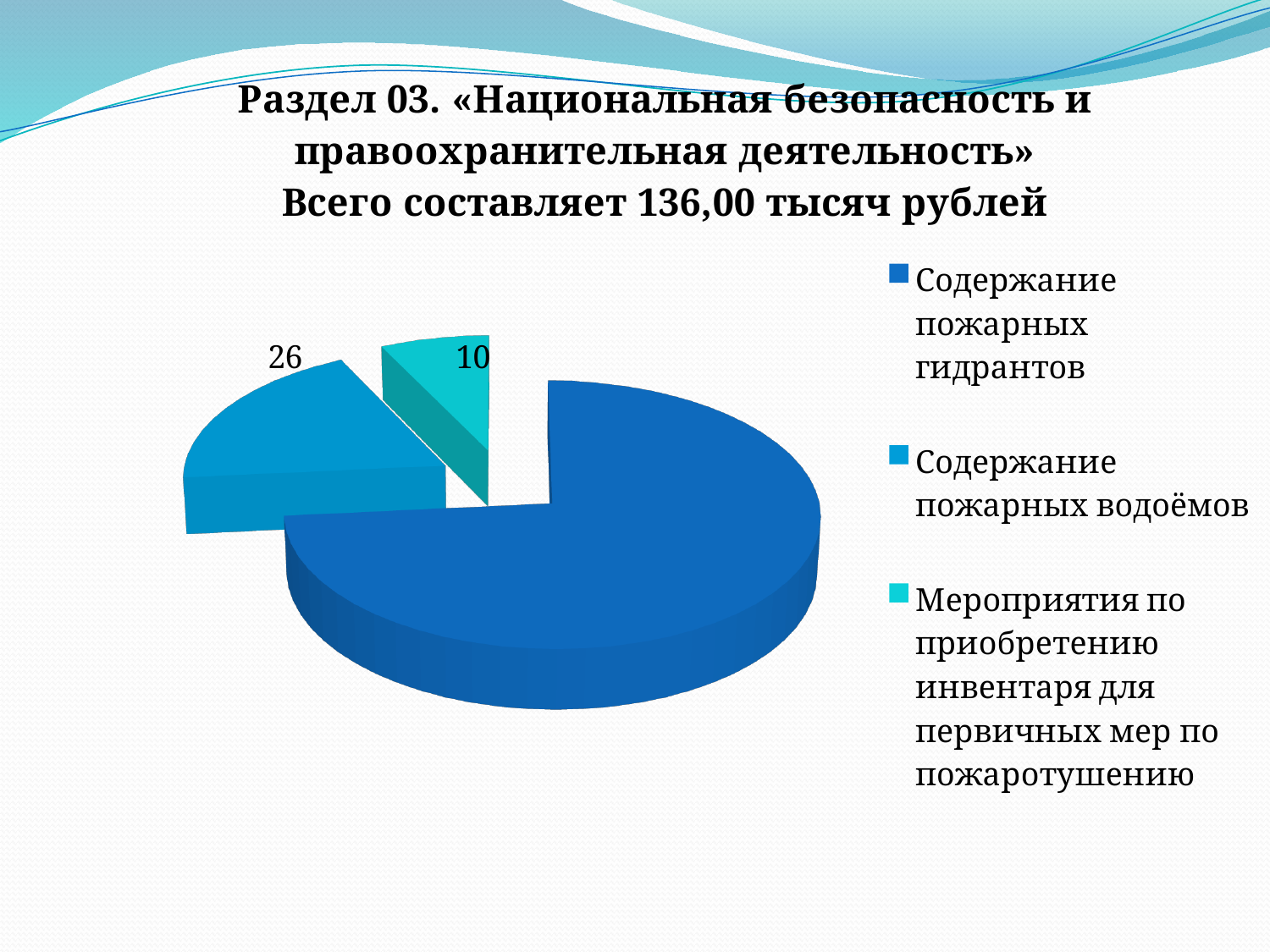
What is the value shown for the slice "Мероприятия по приобретению инвентаря для первичных мер по пожаротушению"? 10 What total amount is stated in the slide title? 136,00 тысяч рублей What is the difference between the values for "Содержание пожарных водоёмов" and "Мероприятия по приобретению инвентаря для первичных мер по пожаротушению"? 16 Which legend entry is shown in the darkest blue colour? Содержание пожарных гидрантов Which category has the smallest slice of the pie? Мероприятия по приобретению инвентаря для первичных мер по пожаротушению How many entries does the legend list? 3 What is the value shown for the slice "Содержание пожарных водоёмов"? 26 How many slices does the pie chart have? 3 Which is larger: the slice for "Содержание пожарных водоёмов" or the slice for "Мероприятия по приобретению инвентаря для первичных мер по пожаротушению"? Содержание пожарных водоёмов Which category has the largest slice of the pie? Содержание пожарных гидрантов What kind of chart is shown on the slide? pie chart